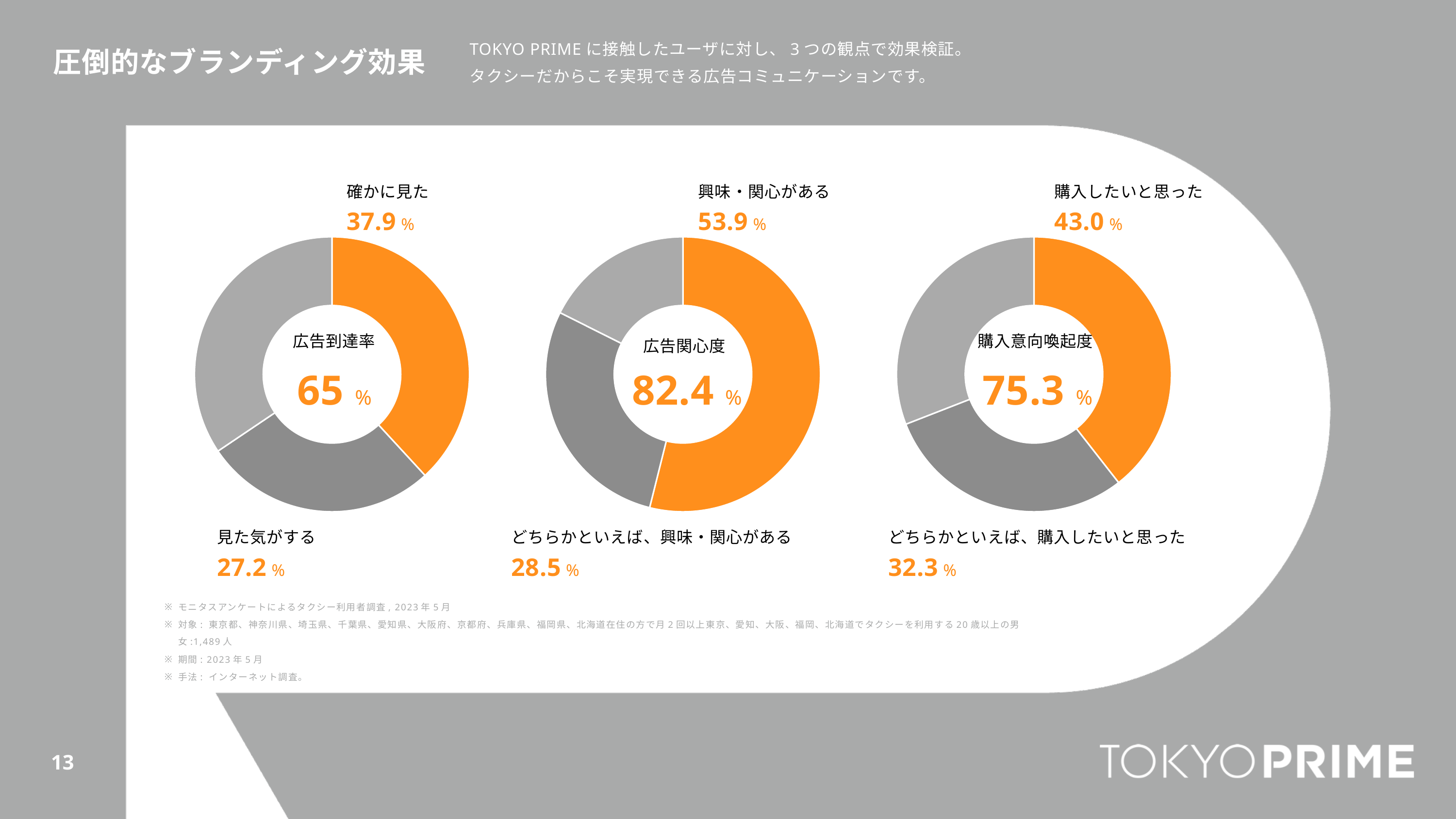
How many slices does the 購入意向喚起度 chart have? 3 Which of the three charts shows the highest overall percentage in its centre? 広告関心度 In the 広告関心度 chart, what is the value for 興味・関心がある? 53.9% In the 広告到達率 chart, what is the difference between 確かに見た and 見た気がする? 10.7% In the 購入意向喚起度 chart, which is larger: 購入したいと思った or どちらかといえば、購入したいと思った? 購入したいと思った In the 購入意向喚起度 chart, what is the value for どちらかといえば、購入したいと思った? 32.3% In the 広告到達率 chart, what is the value for 見た気がする? 27.2% What kind of chart is used for 広告到達率? Donut chart What overall percentage is shown in the centre of the 広告関心度 chart? 82.4% In the 広告関心度 chart, what is the difference between 興味・関心がある and どちらかといえば、興味・関心がある? 25.4% In the 広告到達率 chart, what is the value for 確かに見た? 37.9% In the 広告到達率 chart, what colour is the 確かに見た slice? Orange